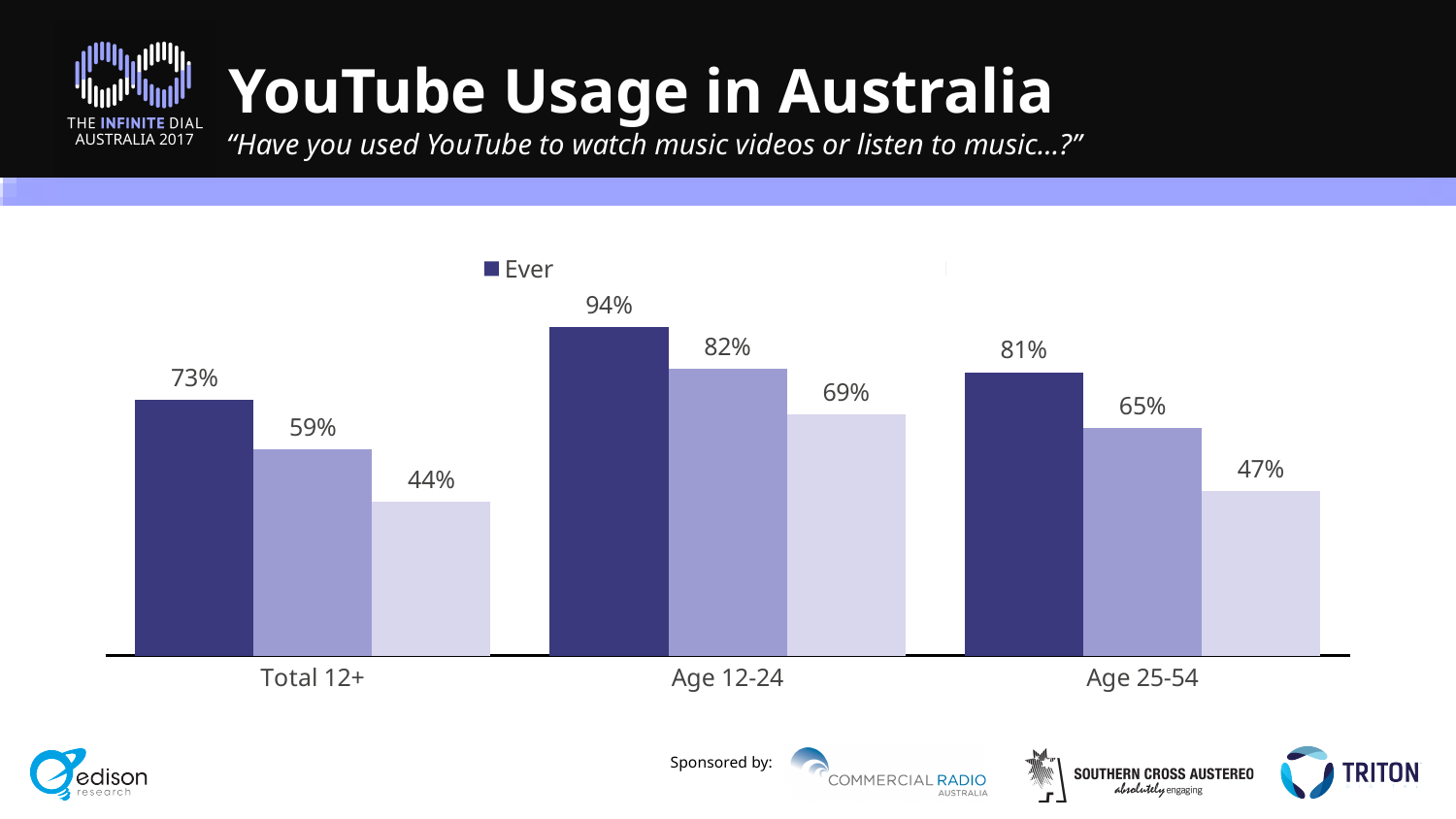
What is the highest value shown in the Age 12-24 group? 94% Which age group has the highest 'Ever' value? Age 12-24 What is the 'Ever' value for Age 25-54? 81% Which category has the lowest 'Ever' value? Total 12+ What kind of chart is shown on the slide? Bar chart What is the 'Ever' value for Age 12-24? 94% How many categories are shown on the x axis? 3 Which is larger: the 'Ever' value for Age 25-54 or for Total 12+? Age 25-54 What is the lowest value shown in the Total 12+ group? 44% What is the 'Ever' value for Total 12+? 73% What is the title of the chart on the slide? YouTube Usage in Australia What is the difference between the 'Ever' values for Age 12-24 and Age 25-54? 13%